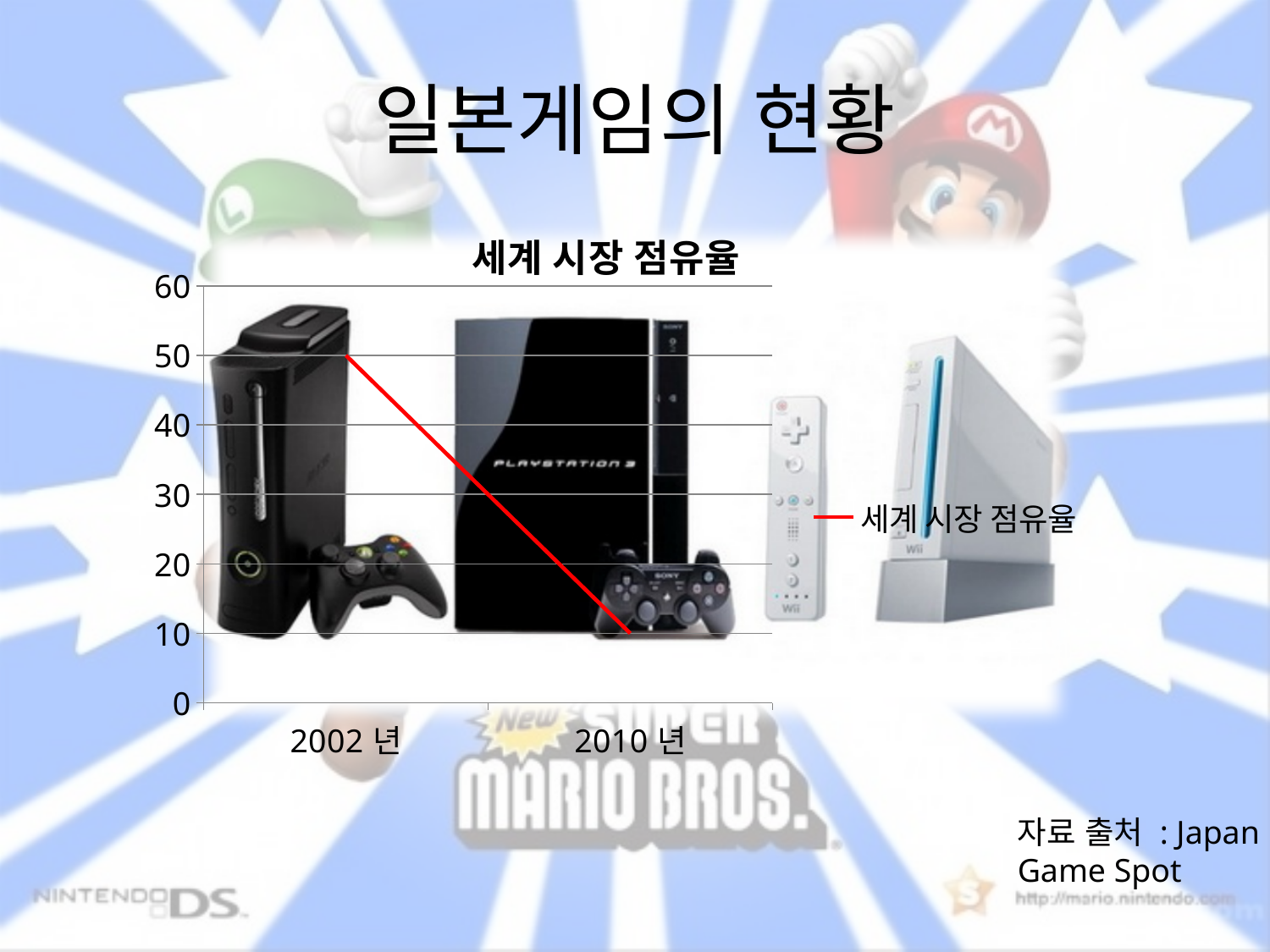
What is the legend entry for the plotted line? 세계 시장 점유율 What is the value for 2010 년? 10 How many series does the legend list? 1 What kind of chart is shown on the slide? line chart Does the value rise or fall from 2002 년 to 2010 년? fall Which category has the lowest value? 2010 년 Is the value for 2010 년 greater or less than 30? less What is the difference between the values for 2002 년 and 2010 년? 40 How many data points are plotted on the line? 2 What is the value for 2002 년? 50 Which year has the higher value, 2002 년 or 2010 년? 2002 년 What is the title of the chart? 세계 시장 점유율